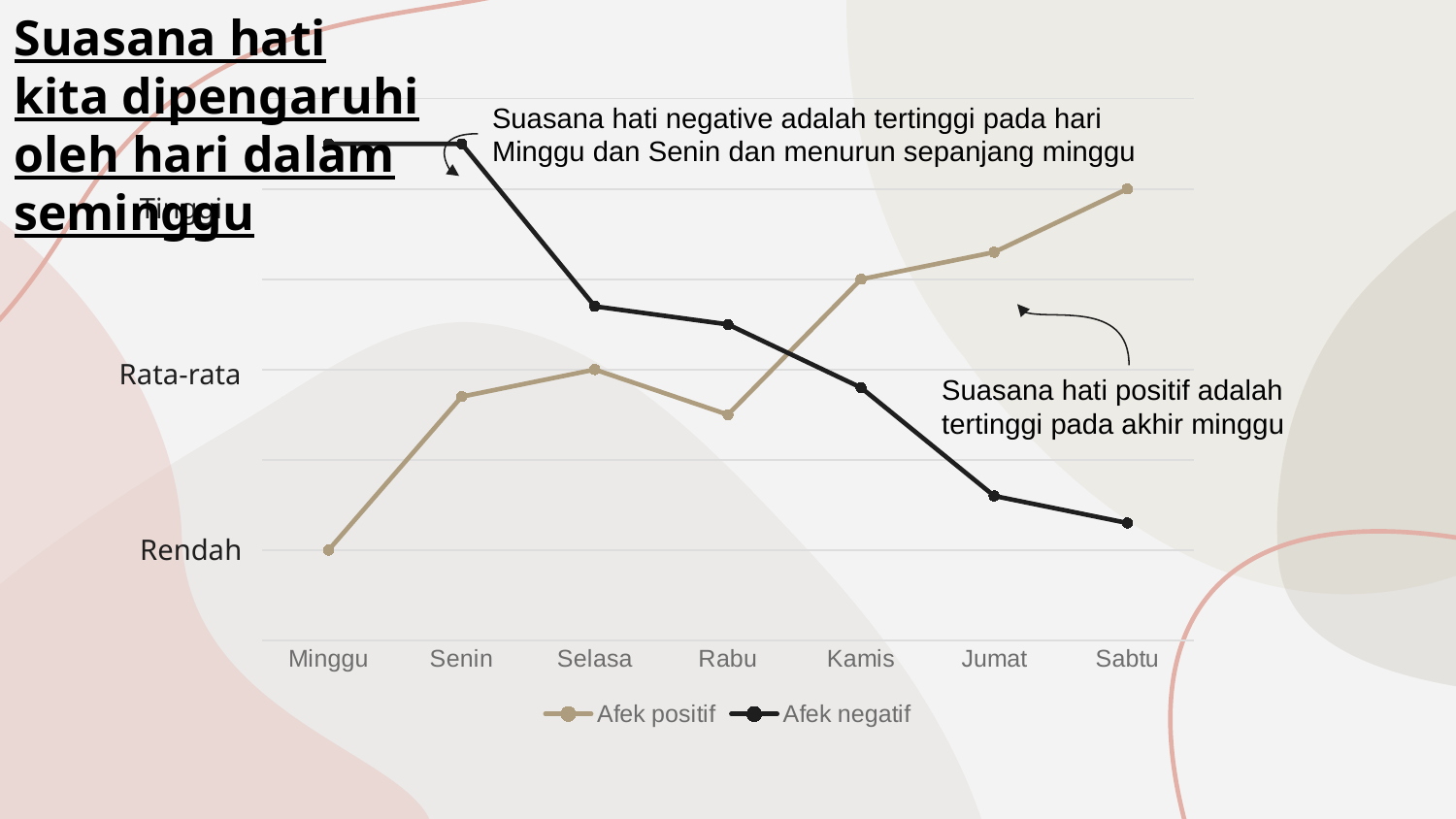
What level does Afek positif reach on Selasa? Rata-rata On Sabtu, which series is higher, Afek positif or Afek negatif? Afek positif How many days are plotted along the x axis? 7 On which day is Afek positif at its highest? Sabtu On which day is Afek negatif at its lowest? Sabtu What kind of chart is shown on the slide? Line chart On which day is Afek positif at its lowest? Minggu Does Afek negatif rise or fall from Minggu to Sabtu? Fall On Minggu, which series is higher, Afek positif or Afek negatif? Afek negatif How many series does the legend list? 2 What are the two series named in the legend? Afek positif and Afek negatif What level does Afek positif reach on Minggu? Rendah